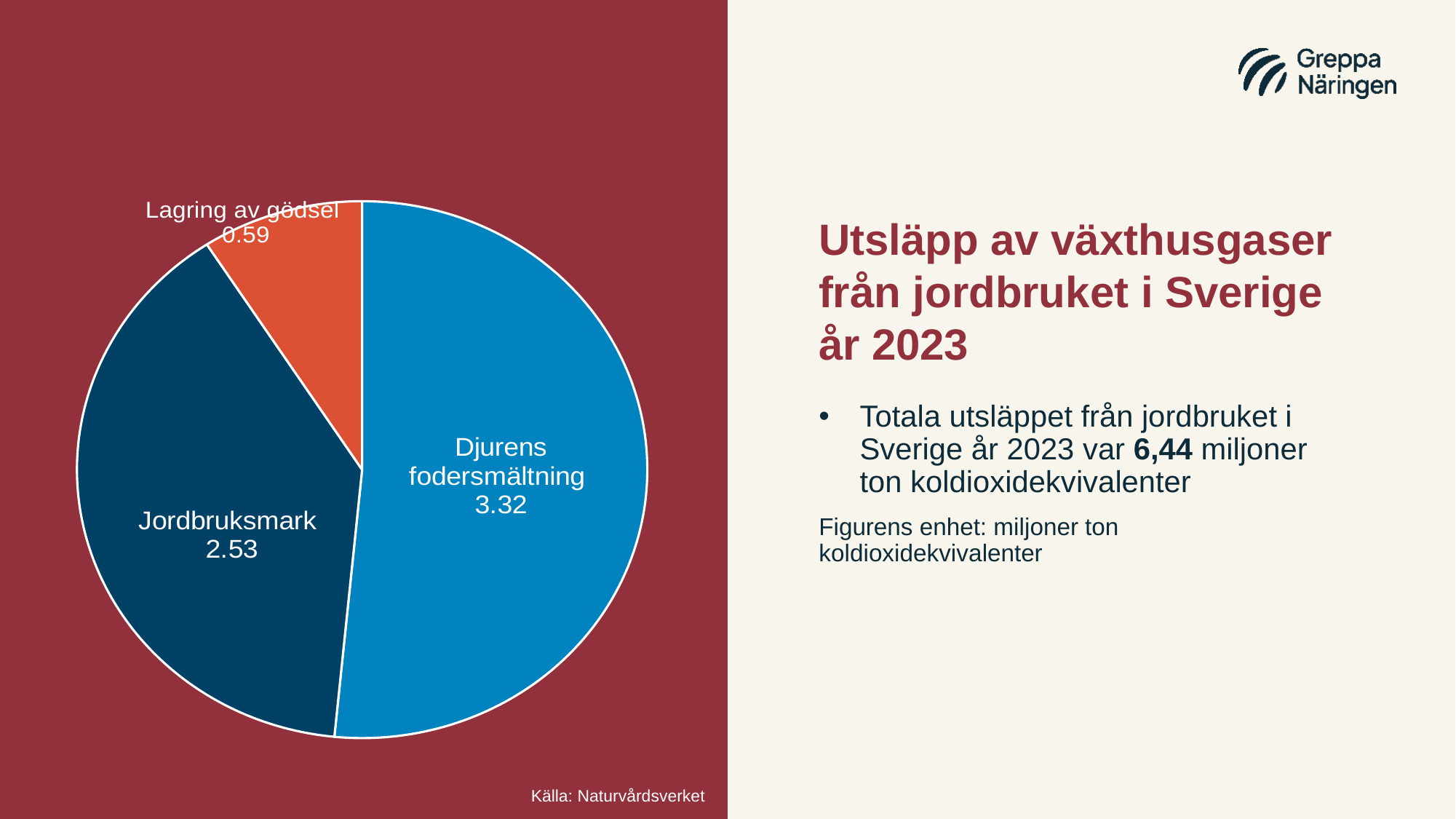
Which category has the smallest slice of the pie? Lagring av gödsel What is the value for Lagring av gödsel? 0.59 What share of the pie does Djurens fodersmältning represent? 51.6% Which category has the largest slice of the pie? Djurens fodersmältning What is the value for Djurens fodersmältning? 3.32 How many slices does the pie chart have? 3 Which is larger, Jordbruksmark or Lagring av gödsel? Jordbruksmark What is the total of all slices in the pie chart? 6.44 What type of chart is shown on the slide? Pie chart What is the difference between the values for Jordbruksmark and Lagring av gödsel? 1.94 What is the difference between the values for Djurens fodersmältning and Jordbruksmark? 0.79 What is the value for Jordbruksmark? 2.53